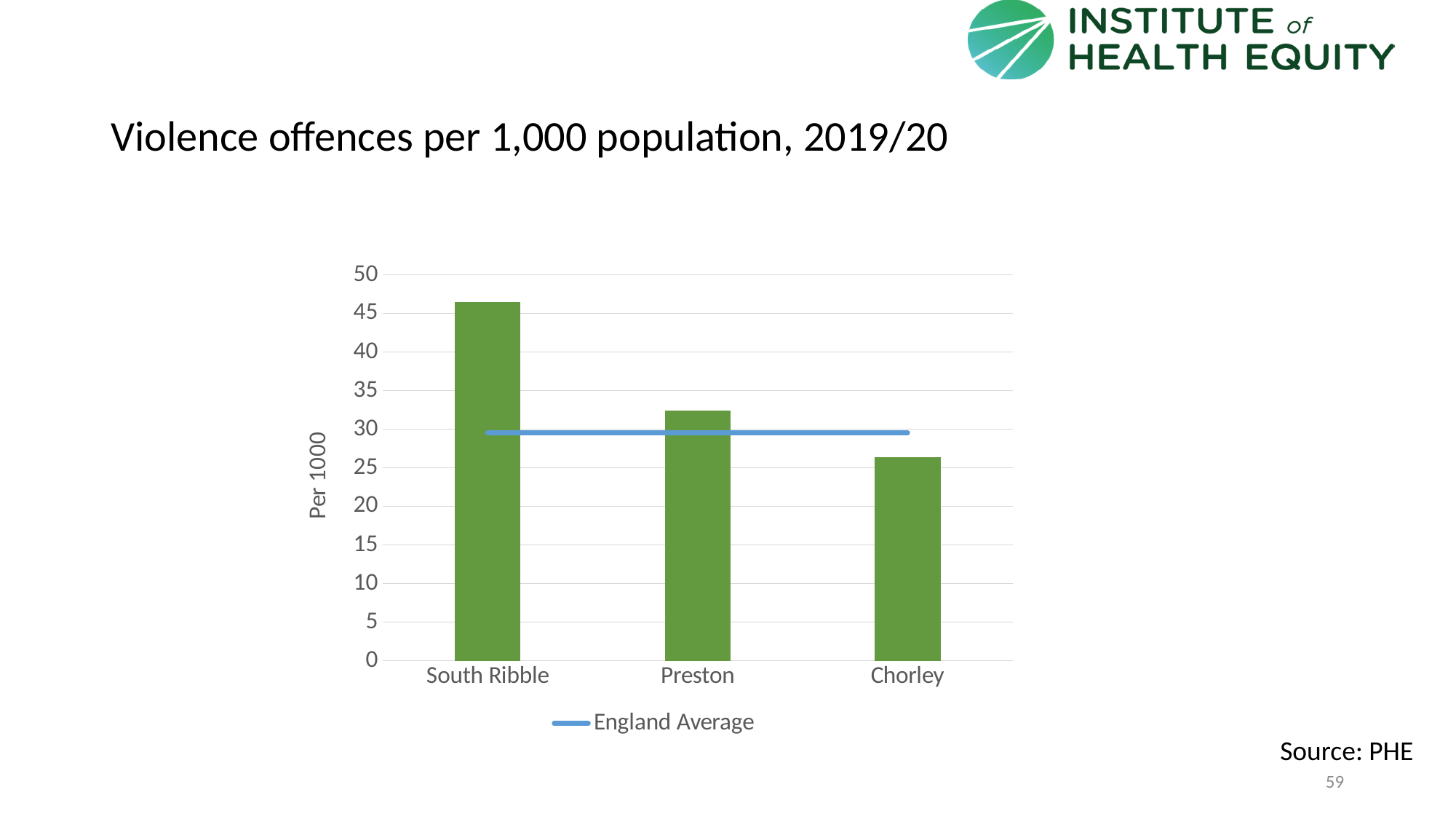
Is the value for South Ribble greater or less than 40? greater How many entries does the legend list? 1 What kind of chart is shown on the slide? bar chart Do the bar values rise or fall from left to right across the chart? fall What does the blue horizontal line on the chart represent? England Average Is the value for Preston greater or less than 30? greater Which area has the lowest rate of violence offences per 1,000 population? Chorley How many areas are plotted as bars on the chart? 3 Which area has the highest rate of violence offences per 1,000 population? South Ribble What is the label on the vertical axis? Per 1000 Is the value for Chorley greater or less than 30? less Which has the higher value, Preston or Chorley? Preston